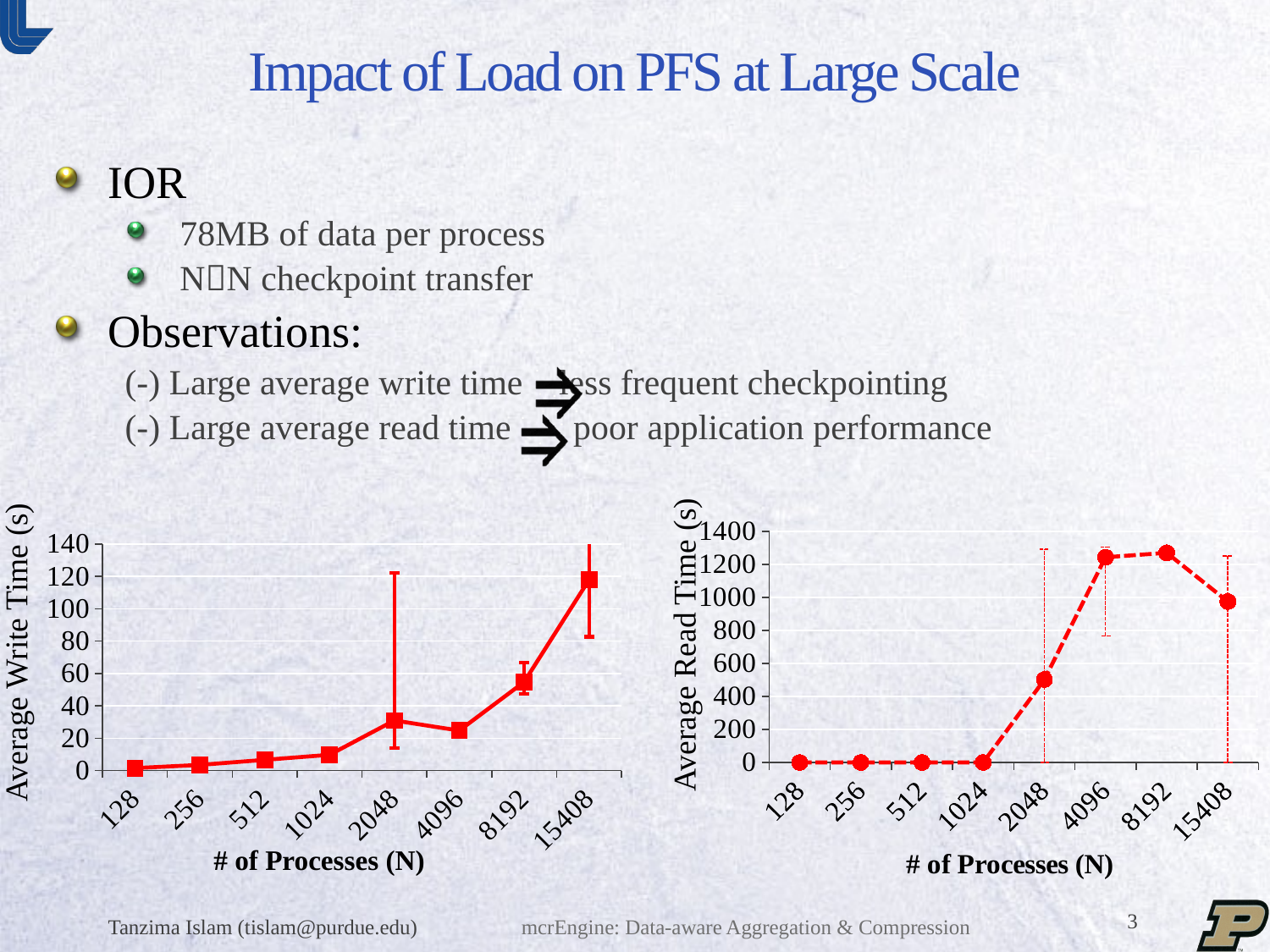
In the left chart (Average Write Time), is the value for 4096 processes greater or less than 40? less In the right chart (Average Read Time), which has the larger average read time: 1024 or 2048 processes? 2048 In the left chart (Average Write Time), is the value for 15408 processes greater or less than 100? greater In the left chart (Average Write Time), is the value for 8192 processes greater or less than 40? greater How many process counts (N) are plotted on the x axis of the right chart (Average Read Time)? 8 What kind of chart is the left chart (Average Write Time)? line chart What is the x-axis title of the left chart? # of Processes (N) In the right chart (Average Read Time), does the average read time rise or fall from 1024 to 4096 processes? rise In the left chart (Average Write Time), which has the larger average write time: 8192 or 15408 processes? 15408 In the left chart (Average Write Time), which number of processes has the highest average write time? 15408